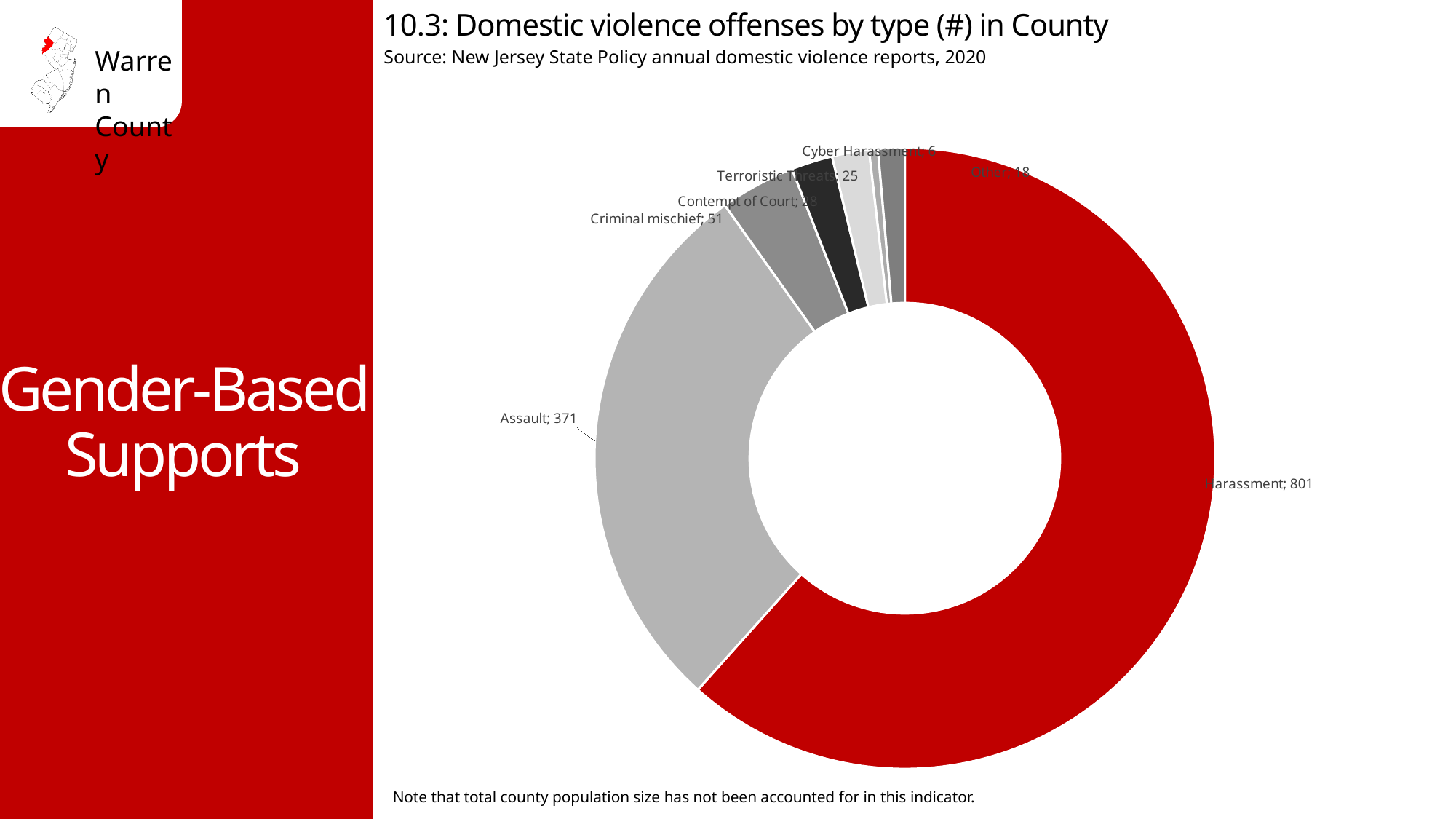
What is the value for Cyber Harassment? 6 Which offense type has the largest number of offenses? Harassment What kind of chart is shown on the slide? Doughnut (pie) chart Which offense type has the smallest number of offenses? Cyber Harassment Which is larger, the value for Assault or the value for Criminal mischief? Assault What is the source cited for the chart? New Jersey State Policy annual domestic violence reports, 2020 What is the value for Criminal mischief? 51 What is the difference between the Harassment and Assault values? 430 What is the value for Terroristic Threats? 25 What is the number of Assault offenses shown in the chart? 371 What is the number of Harassment offenses shown in the chart? 801 How many offense types (slices) are shown in the chart? 7